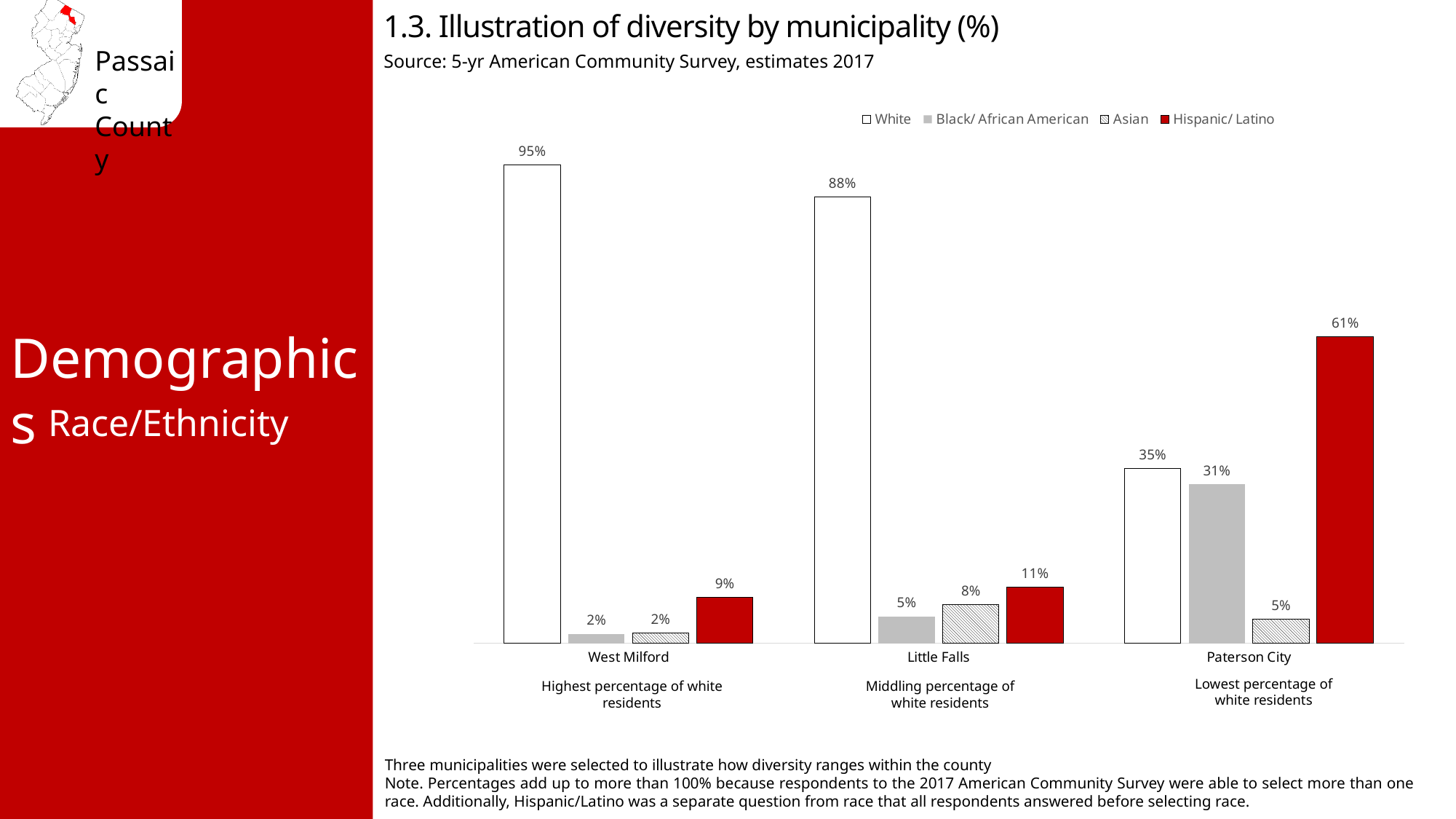
What kind of chart is shown on the slide? Bar chart What is the Black/ African American percentage for Paterson City? 31% What is the difference between the White percentage in West Milford and in Paterson City? 60% What is the Hispanic/ Latino percentage for Paterson City? 61% What is the Asian percentage for Little Falls? 8% What is the White percentage for West Milford? 95% Which municipality has the lowest Hispanic/ Latino percentage? West Milford Which municipality has the highest White percentage? West Milford How many series does the legend list? 4 How many municipalities are shown on the chart? 3 Which colour represents Hispanic/ Latino in the chart? Red Which is larger in Paterson City: the White percentage or the Hispanic/ Latino percentage? Hispanic/ Latino